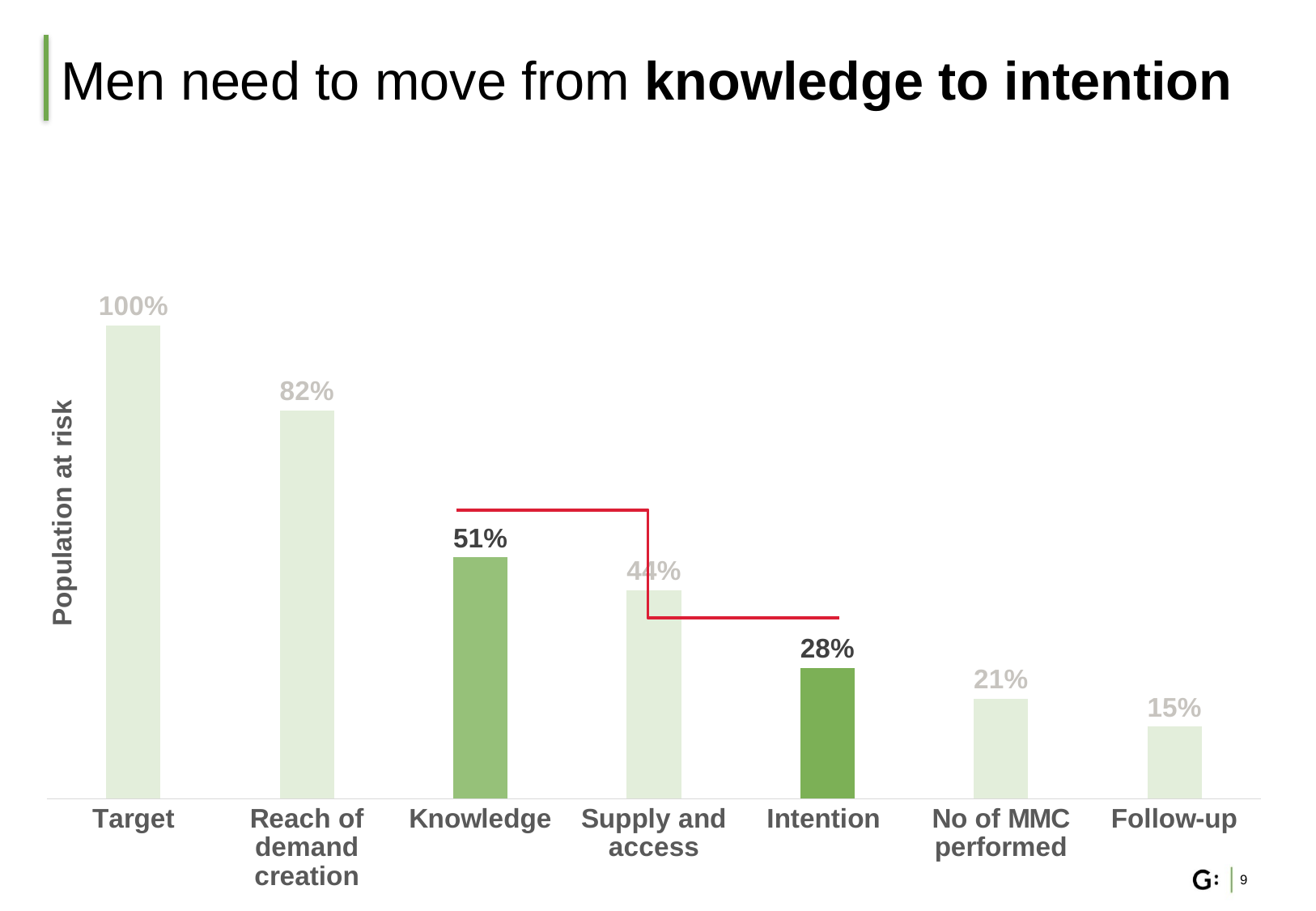
What kind of chart is shown on the slide? Bar chart What is the label of the y axis? Population at risk What is the value for Intention? 28% Which category has the highest value? Target Do the values rise or fall from left to right along the x axis? Fall What is the value for Reach of demand creation? 82% What is the value for Follow-up? 15% Which is larger, the value for Supply and access or the value for No of MMC performed? Supply and access How many categories are shown on the x axis? 7 Which category has the lowest value? Follow-up What is the value for Knowledge? 51% What is the difference between the values for Knowledge and Intention? 23%